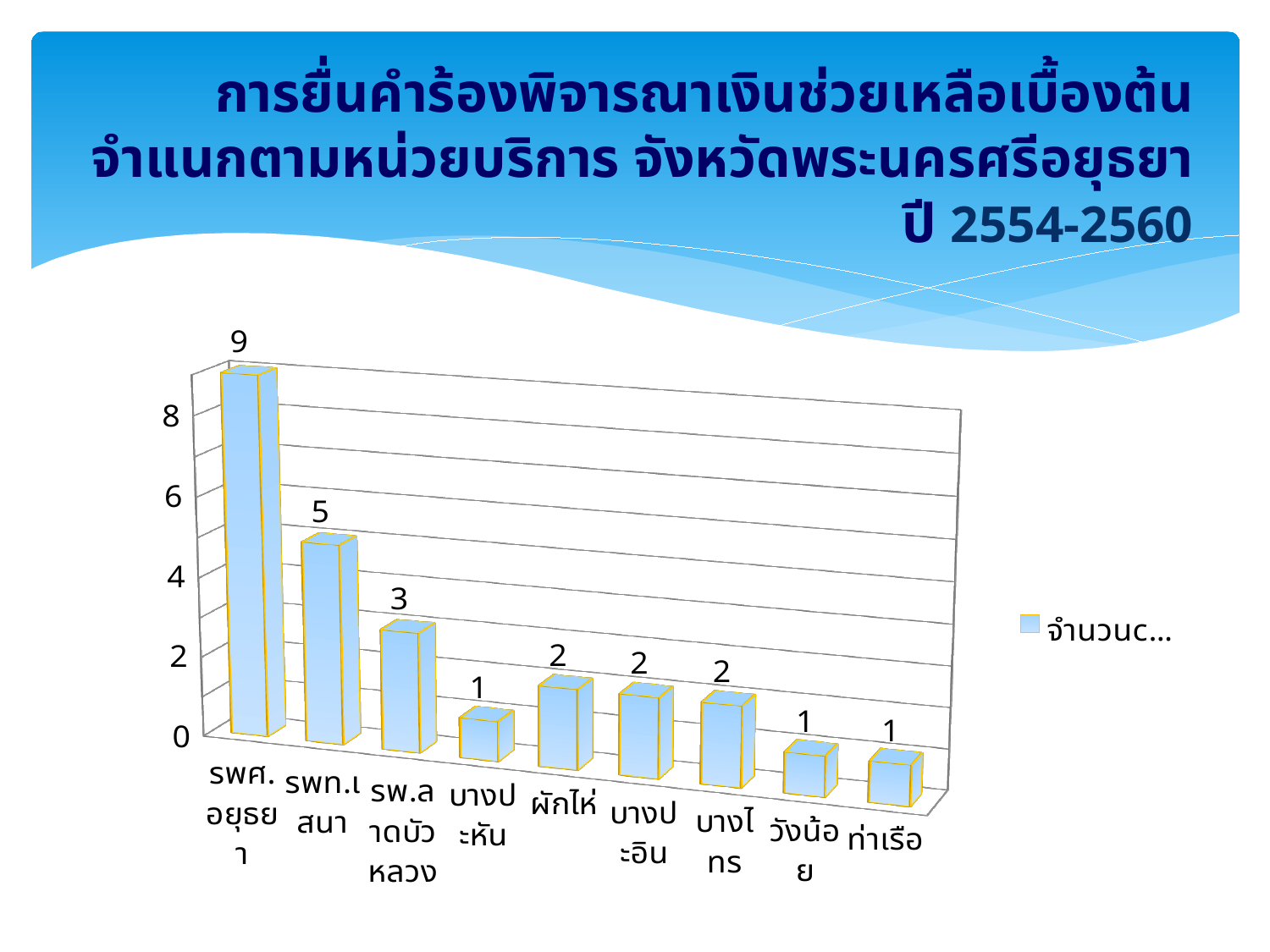
What is the value for รพท.เสนา? 5 What is the difference between the values for รพศ.อยุธยา and รพท.เสนา? 4 How many categories are shown on the x axis? 9 Which category has the highest value? รพศ.อยุธยา What is the value for รพ.ลาดบัวหลวง? 3 What years does the chart title say the data covers? 2554-2560 What is the value for ผักไห่? 2 Is the value for รพท.เสนา greater or less than 4? greater What is the value for รพศ.อยุธยา? 9 Which is larger, the value for รพ.ลาดบัวหลวง or the value for บางปะอิน? รพ.ลาดบัวหลวง What kind of chart is shown on the slide? bar chart What is the value for ท่าเรือ? 1